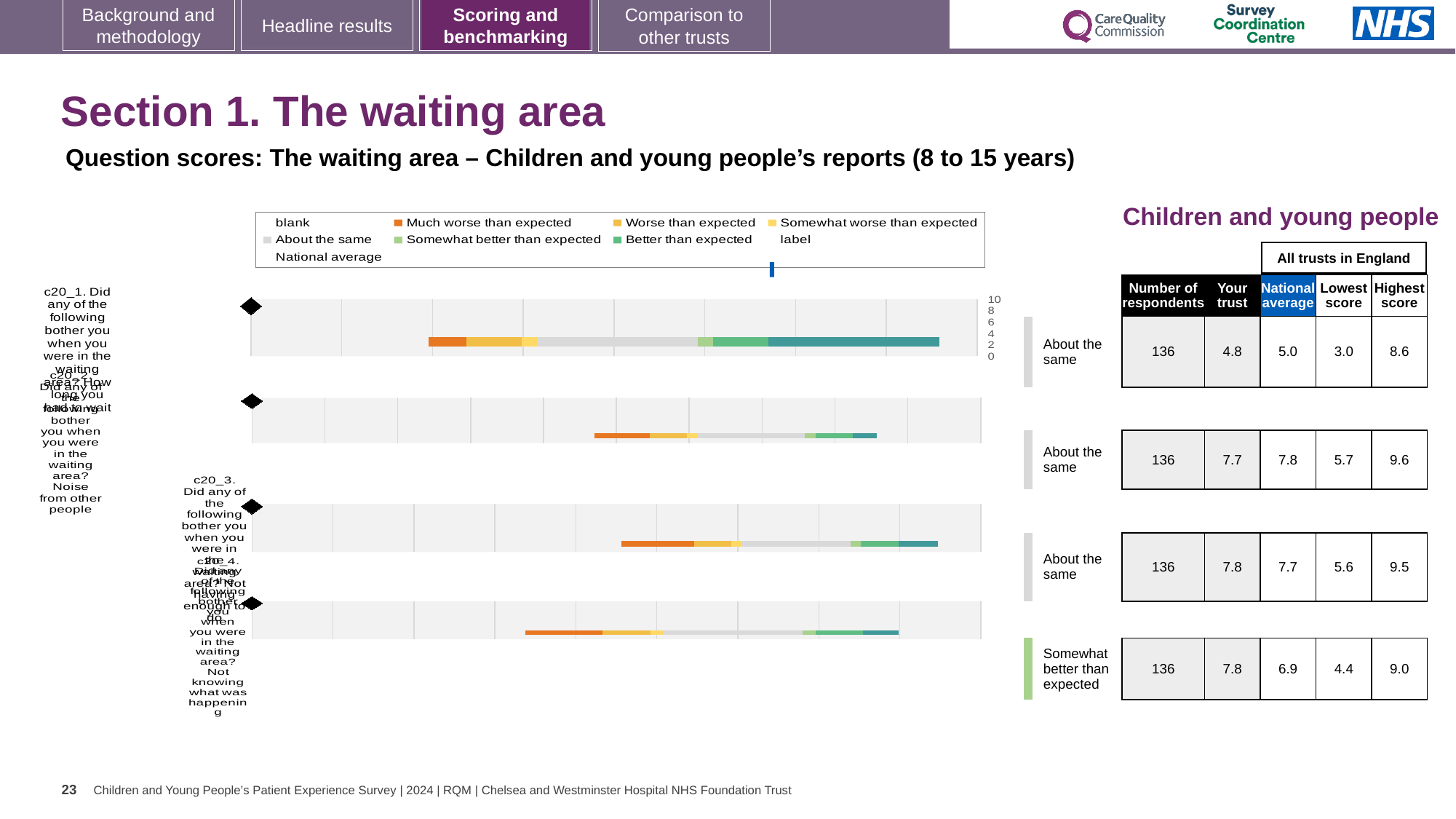
In the legend, which category is shown in dark orange? Much worse than expected What benchmark category is the bottom chart (c20_4) assigned? Somewhat better than expected Which has the higher 'Your trust' score: the top chart (c20_1) or the second chart (c20_2)? c20_2 How many respondents are shown for the third chart (c20_3)? 136 For the bottom chart (c20_4), what is the difference between the 'Your trust' score and the national average? 0.9 For the top chart (c20_1), what is the 'Your trust' score shown in the table? 4.8 What kind of chart is used to show the question scores on this slide? bar chart In the legend, which category is shown in light grey? About the same For the top chart (c20_1), what is the national average score? 5.0 For the bottom chart (c20_4), what is the lowest score across all trusts in England? 4.4 How many question score charts are shown on the slide? 4 For the second chart (c20_2), what is the highest score across all trusts in England? 9.6